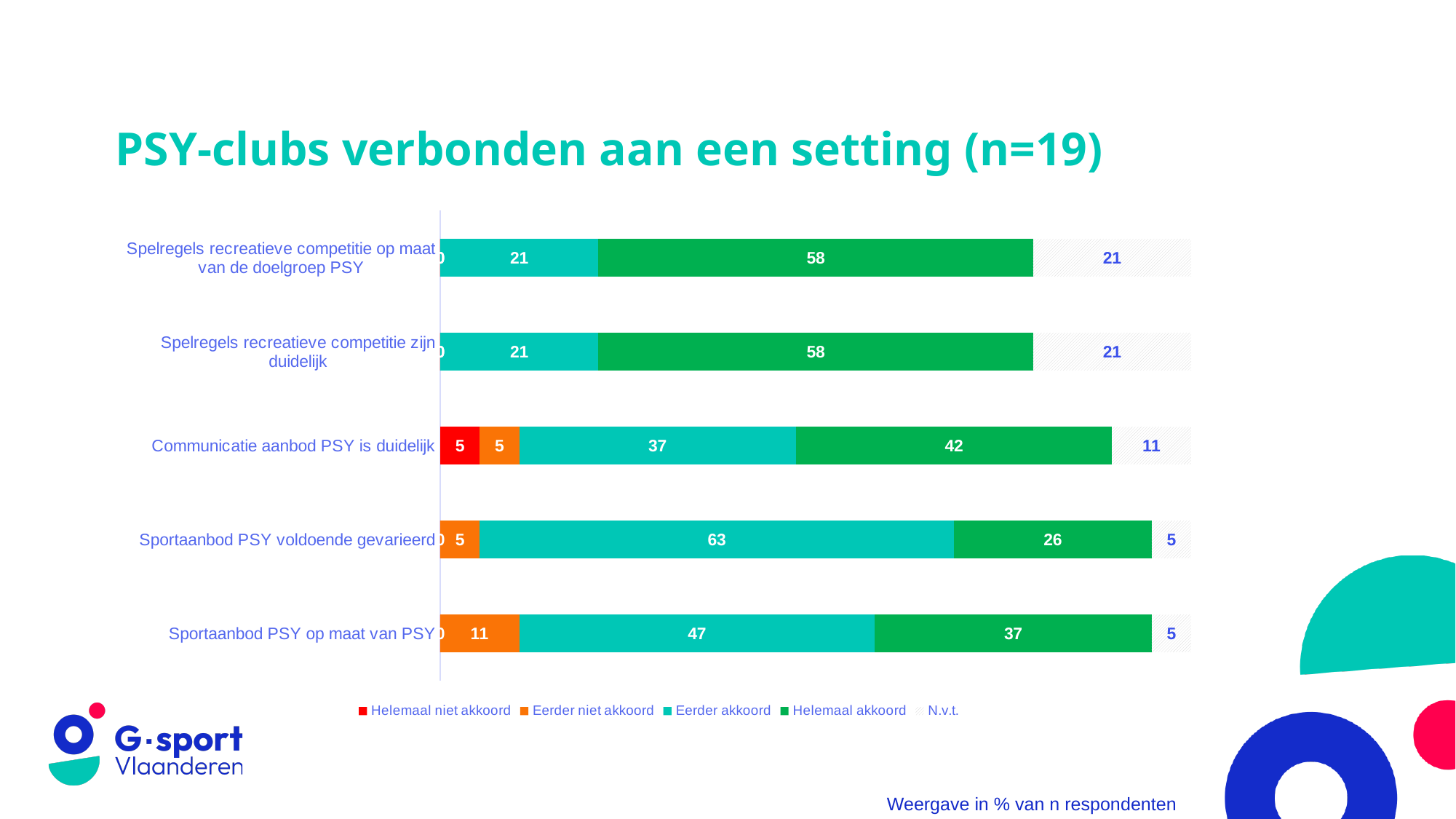
Which category has the lowest 'Helemaal akkoord' value? Sportaanbod PSY voldoende gevarieerd Which has the larger 'Helemaal akkoord' value: 'Sportaanbod PSY op maat van PSY' or 'Sportaanbod PSY voldoende gevarieerd'? Sportaanbod PSY op maat van PSY What is the 'N.v.t.' value for 'Spelregels recreatieve competitie zijn duidelijk'? 21 What is the 'Eerder niet akkoord' value for 'Sportaanbod PSY op maat van PSY'? 11 What is the title of the chart on the slide? PSY-clubs verbonden aan een setting (n=19) What kind of chart is shown on the slide? bar chart Which category has the highest 'Eerder akkoord' value? Sportaanbod PSY voldoende gevarieerd What is the 'Helemaal akkoord' value for 'Communicatie aanbod PSY is duidelijk'? 42 How many series does the legend list? 5 What is the 'Eerder akkoord' value for 'Sportaanbod PSY voldoende gevarieerd'? 63 For 'Communicatie aanbod PSY is duidelijk', what is the difference between the 'Helemaal akkoord' and 'Eerder akkoord' values? 5 How many categories (statements) are plotted in the chart? 5